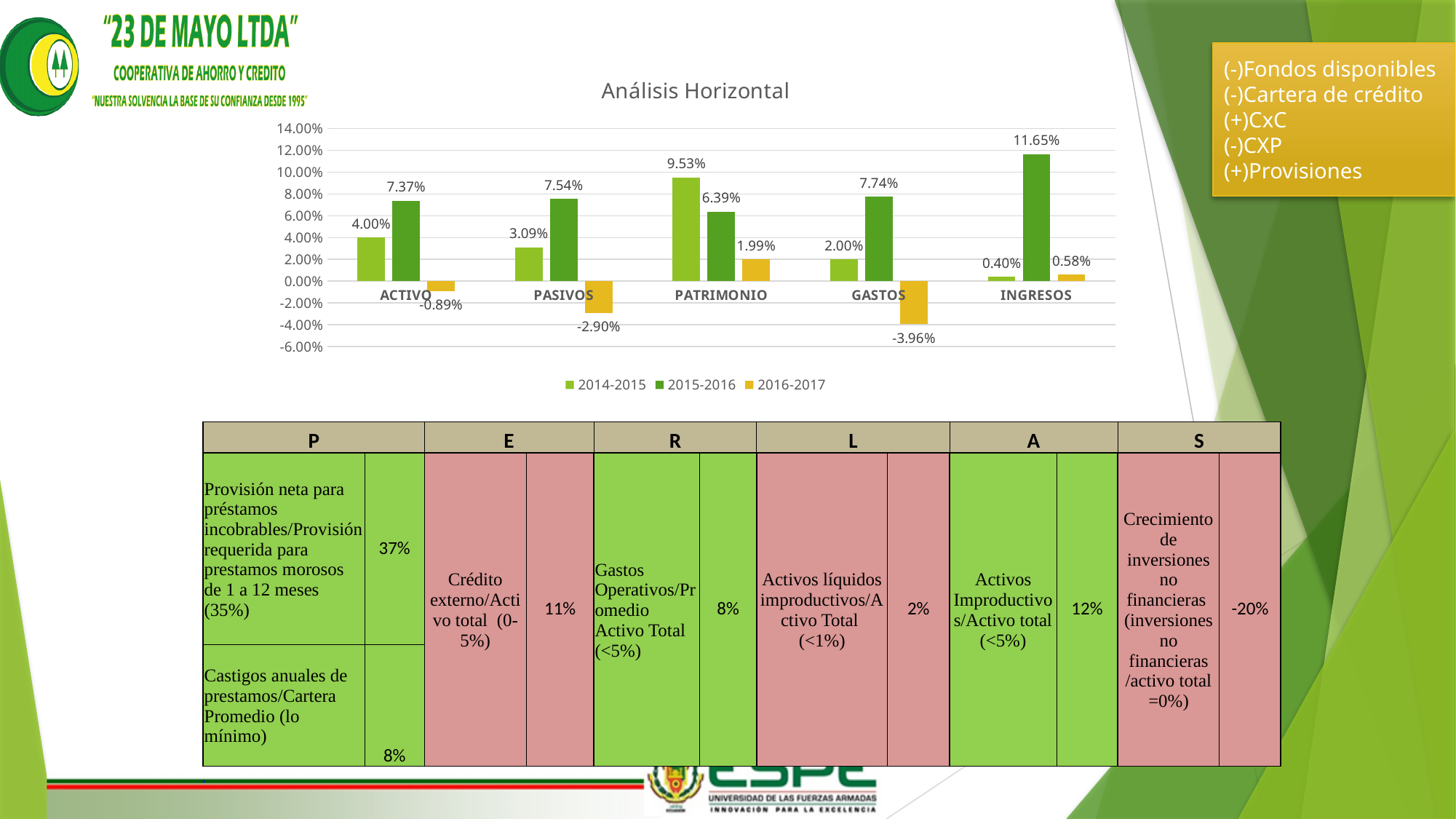
What is the value for INGRESOS in the 2015-2016 series? 11.65% What type of chart is shown on the slide? Bar chart Which category has the highest value in the 2015-2016 series? INGRESOS What is the value for PATRIMONIO in the 2014-2015 series? 9.53% Which category has the lowest value in the 2016-2017 series? GASTOS What is the difference between the 2015-2016 and 2014-2015 values for ACTIVO? 3.37% How many categories are shown on the x axis of the chart? 5 What is the value for PASIVOS in the 2016-2017 series? -2.90% Which category has the lowest value in the 2014-2015 series? INGRESOS What is the value for GASTOS in the 2016-2017 series? -3.96% Which is larger for PATRIMONIO: the 2014-2015 value or the 2015-2016 value? 2014-2015 How many series does the chart legend list? 3